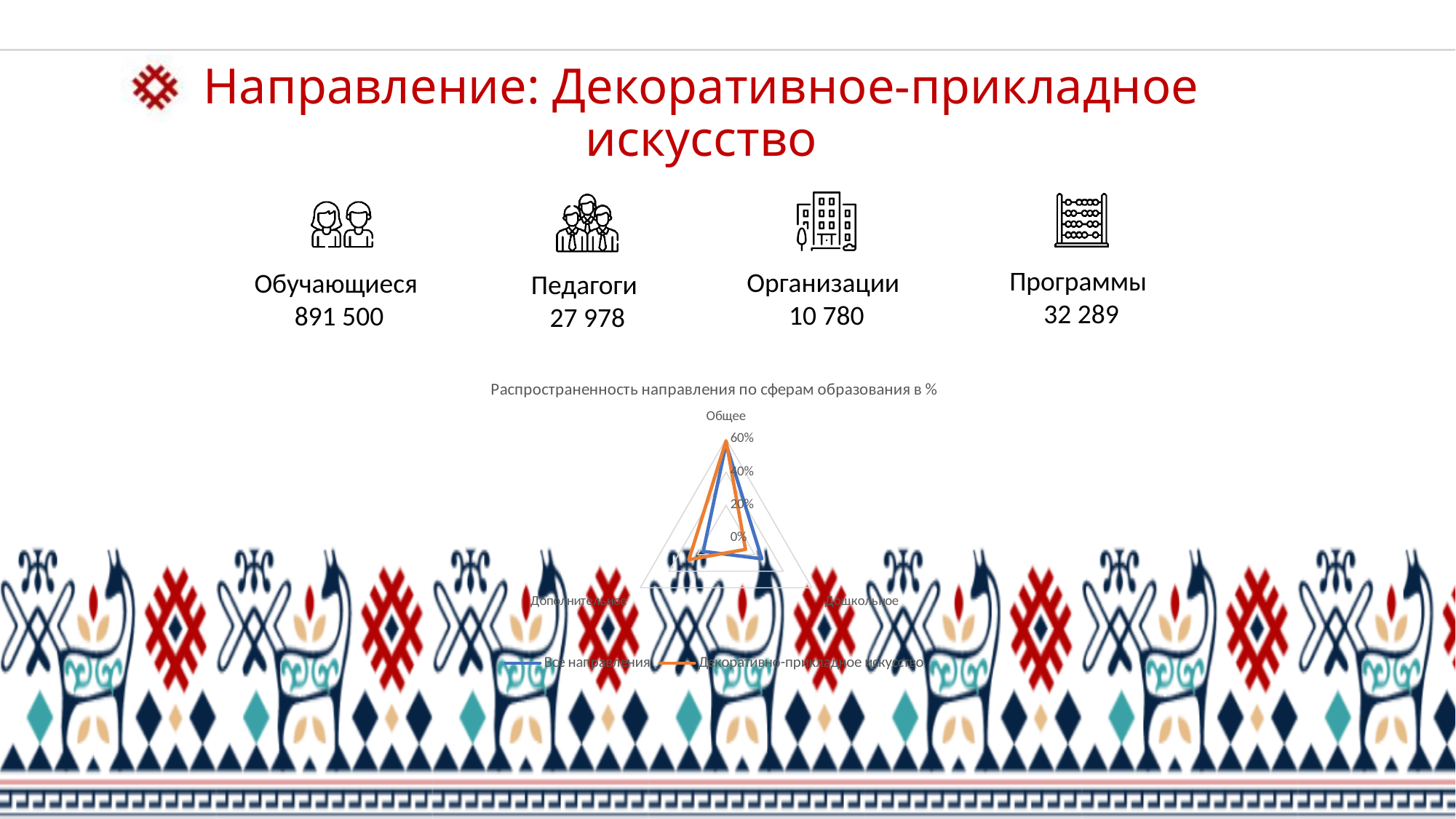
What is the title of the chart? Распространенность направления по сферам образования в % Is the value for Общее in the Декоративно-прикладное искусство series greater or less than 40%? greater How many categories (axes) does the radar chart have? 3 Is the value for Дополнительное in the Все направления series greater or less than 40%? less How many series does the chart legend list? 2 Is the value for Дошкольное in the Декоративно-прикладное искусство series greater or less than 40%? less For the Общее category, which series has the larger value: Все направления or Декоративно-прикладное искусство? Декоративно-прикладное искусство For which category does the Декоративно-прикладное искусство series reach its highest value? Общее Which series is drawn in orange on the chart? Декоративно-прикладное искусство What kind of chart is shown on the slide? radar chart For which category does the Все направления series reach its highest value? Общее